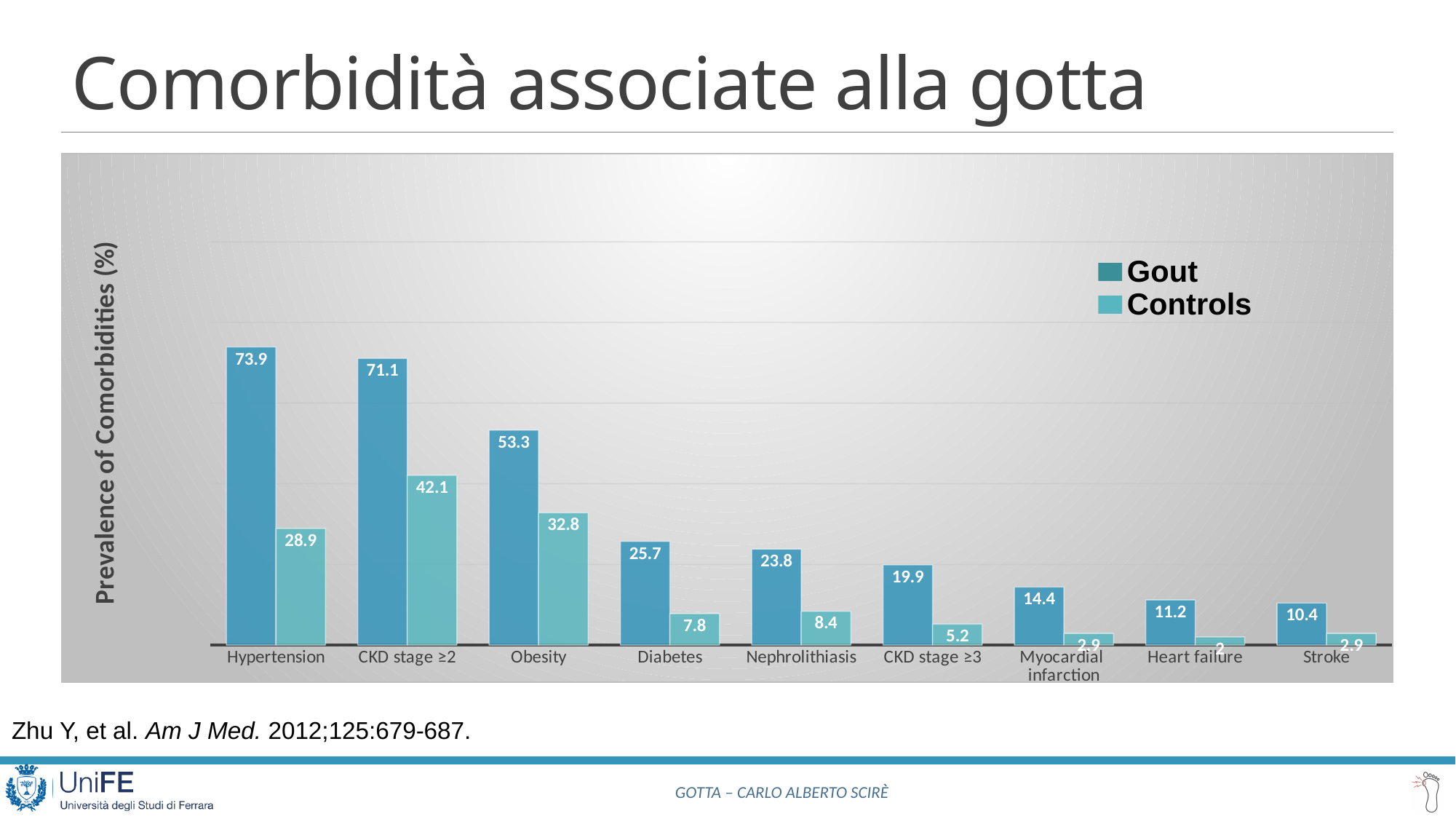
Which category has the lowest Gout value? Stroke Which is larger: the Gout value for Nephrolithiasis or the Gout value for CKD stage ≥3? Nephrolithiasis What kind of chart is shown on the slide? Bar chart What is the Controls value for Diabetes? 7.8 How many categories are shown on the x axis? 9 What is the difference between the Gout and Controls values for Hypertension? 45.0 What is the Controls value for CKD stage ≥2? 42.1 What is the label of the y axis? Prevalence of Comorbidities (%) What is the Gout value for Obesity? 53.3 How many series does the legend list? 2 Which category has the highest Gout value? Hypertension What is the Gout value for Hypertension? 73.9